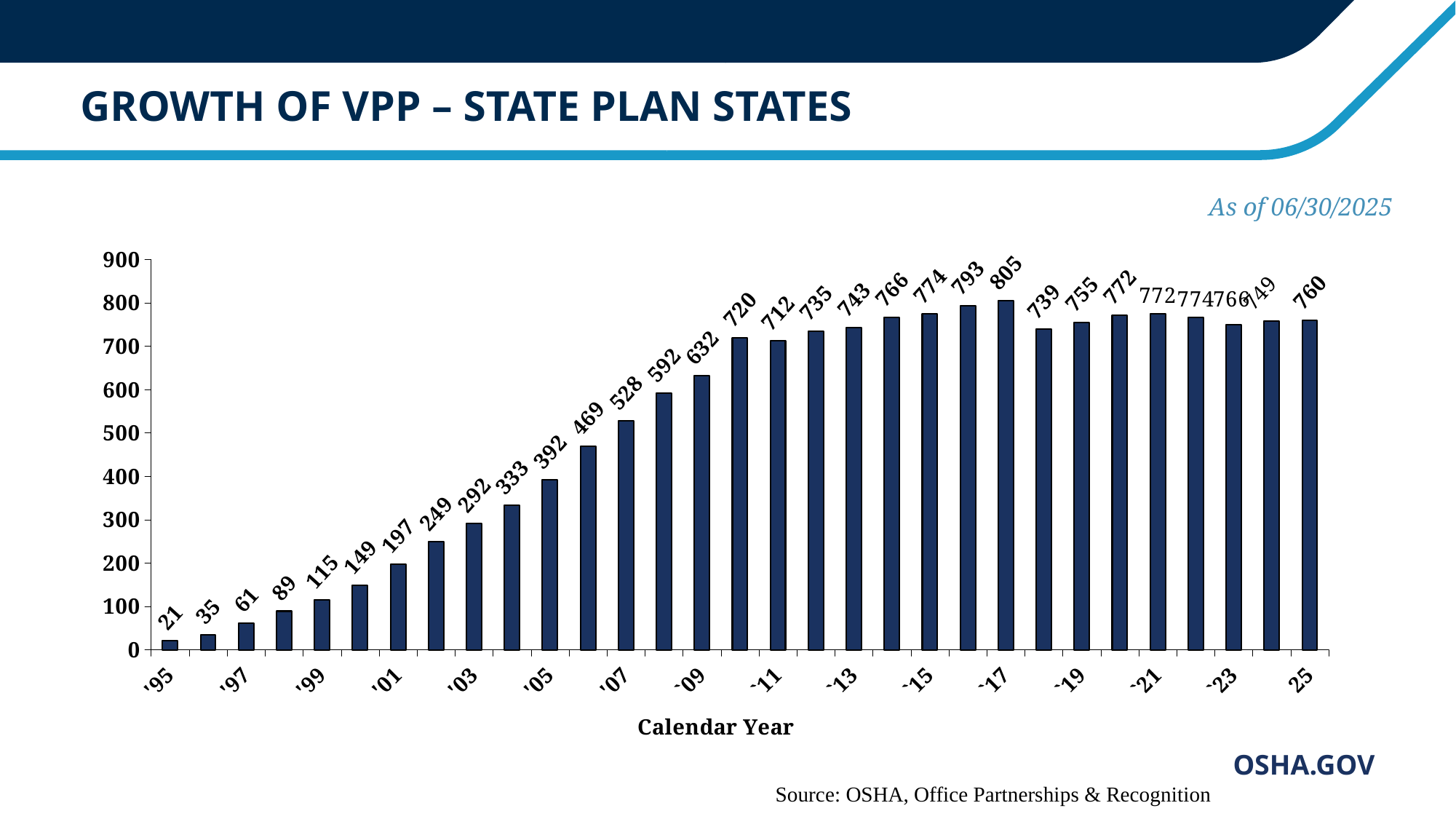
Which is larger, the value for '11 or the value for '13? '13 What is the value for '19? 755 What is the value for '07? 528 What is the difference between the values for '25 and '95? 739 Is the value for '05 greater or less than 400? less Which year has the lowest value? '95 What is the difference between the values for '17 and '19? 50 What type of chart is shown on the slide? bar chart What is the value for '95? 21 Which year has the highest value? '17 How many bars are plotted in the chart? 31 What is the value for '25? 760